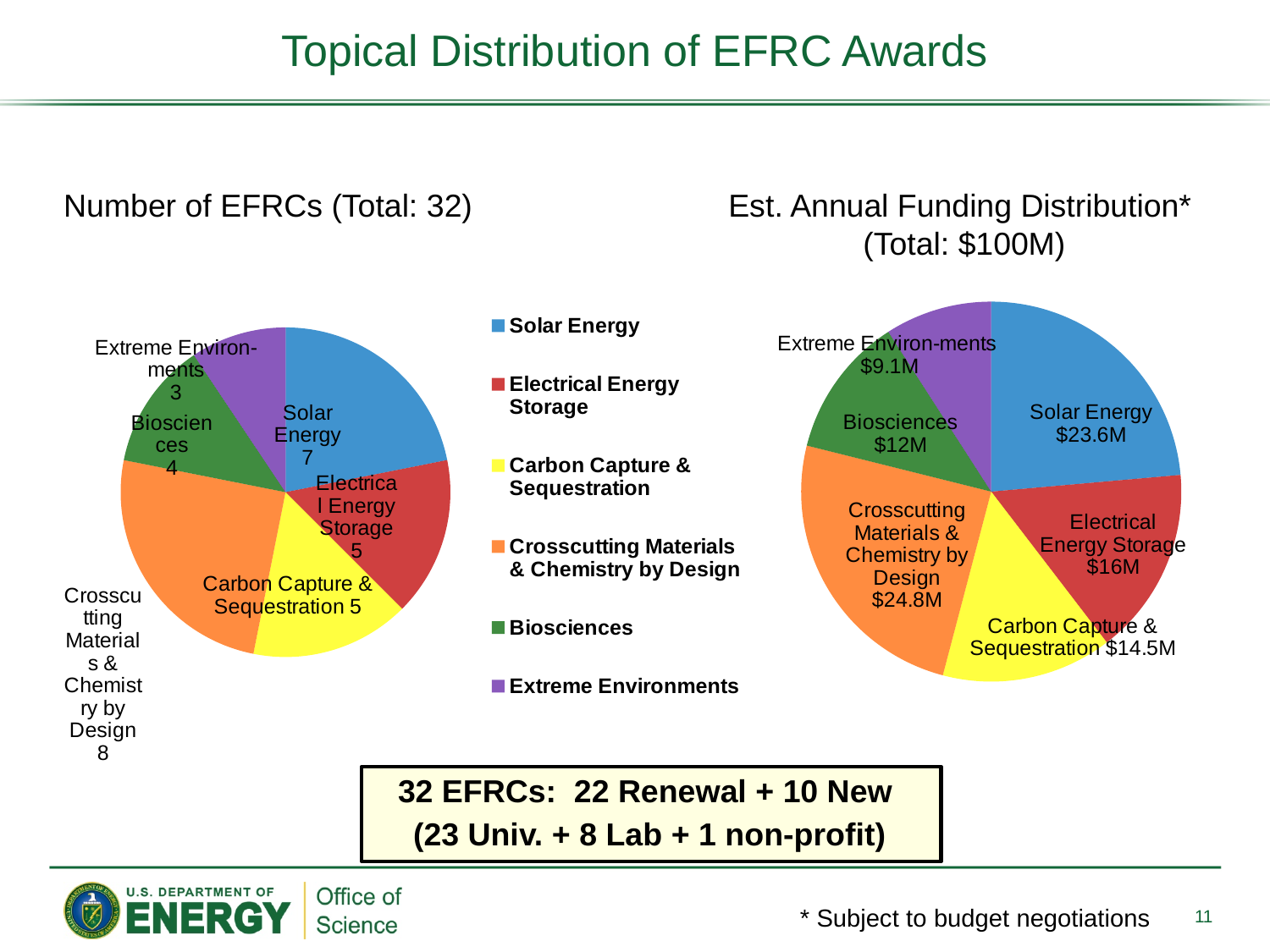
In the Est. Annual Funding Distribution pie chart, what share of the $100M total goes to Biosciences? 12% In the Number of EFRCs pie chart, which topic has the fewest EFRCs? Extreme Environments How many topics does the legend between the two pie charts list? 6 In the Est. Annual Funding Distribution pie chart, which receives more funding, Biosciences or Carbon Capture & Sequestration? Carbon Capture & Sequestration In the Est. Annual Funding Distribution pie chart, which topic receives the largest funding? Crosscutting Materials & Chemistry by Design In the Est. Annual Funding Distribution pie chart, what is the difference in funding between Solar Energy and Electrical Energy Storage? $7.6M In the Number of EFRCs pie chart, how many more EFRCs does Solar Energy have than Extreme Environments? 4 In the Est. Annual Funding Distribution pie chart, what is the funding for Electrical Energy Storage? $16M In the Number of EFRCs pie chart, how many EFRCs are in Solar Energy? 7 In the Est. Annual Funding Distribution pie chart, what is the funding for Extreme Environments? $9.1M In the Number of EFRCs pie chart, how many EFRCs are in Biosciences? 4 In the Number of EFRCs pie chart, which topic has the most EFRCs? Crosscutting Materials & Chemistry by Design